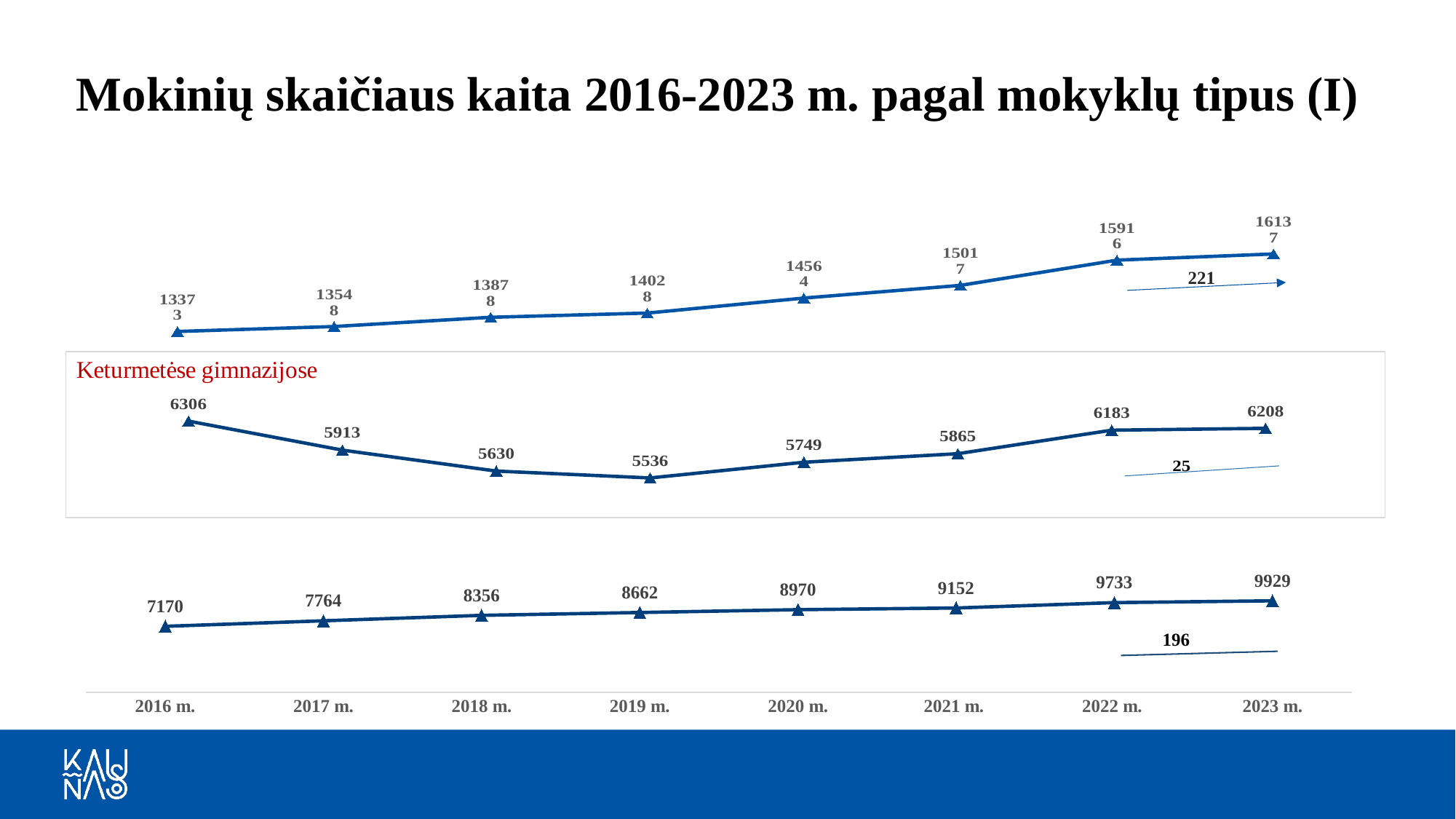
In the middle chart titled "Keturmetėse gimnazijose", what is the value for 2016 m.? 6306 In the middle chart titled "Keturmetėse gimnazijose", which year has the highest value? 2016 m. In the bottom chart on the slide, what is the difference between the values for 2023 m. and 2022 m.? 196 How many years (data points) are plotted in the bottom chart on the slide? 8 In the bottom chart on the slide, what is the value for 2016 m.? 7170 In the bottom chart on the slide, which year has the highest value? 2023 m. In the middle chart titled "Keturmetėse gimnazijose", which is larger, the value for 2017 m. or for 2021 m.? 2017 m. In the bottom chart on the slide, what is the value for 2020 m.? 8970 In the middle chart titled "Keturmetėse gimnazijose", what is the difference between the values for 2023 m. and 2022 m.? 25 What kind of chart is the middle chart titled "Keturmetėse gimnazijose"? line chart In the bottom chart on the slide, do the values rise or fall from 2016 m. to 2023 m.? rise In the middle chart titled "Keturmetėse gimnazijose", which year has the lowest value? 2019 m.